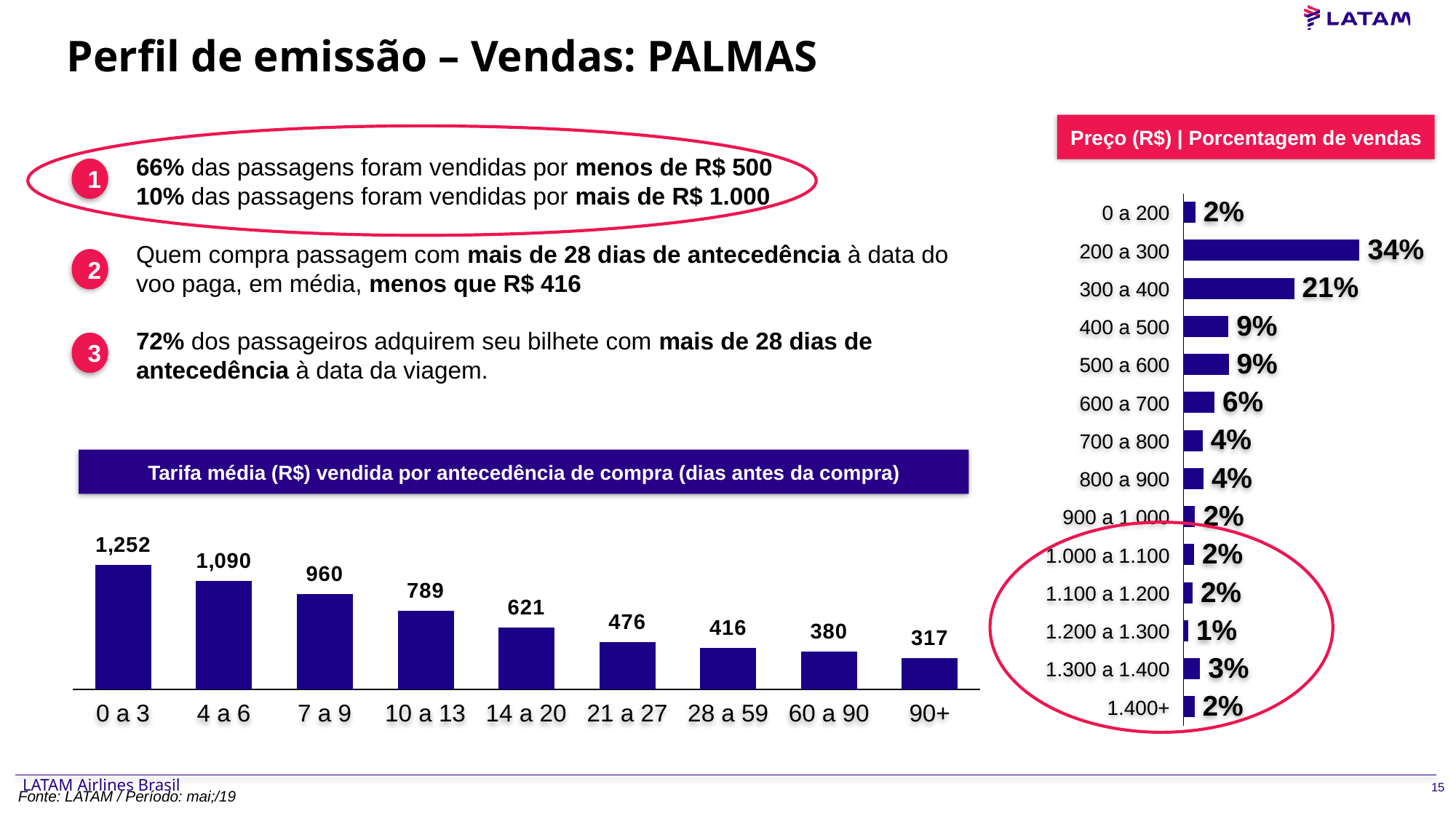
In the 'Tarifa média (R$) vendida por antecedência de compra' chart, do the values rise or fall from left to right along the x axis? fall What kind of chart is the 'Preço (R$) | Porcentagem de vendas' chart? bar chart In the 'Preço (R$) | Porcentagem de vendas' chart, what is the value for '300 a 400'? 21% In the 'Tarifa média (R$) vendida por antecedência de compra' chart, what is the value for '0 a 3'? 1,252 In the 'Preço (R$) | Porcentagem de vendas' chart, which price range has the highest percentage of sales? 200 a 300 In the 'Tarifa média (R$) vendida por antecedência de compra' chart, what is the value for '28 a 59'? 416 In the 'Tarifa média (R$) vendida por antecedência de compra' chart, which category has the lowest value? 90+ In the 'Tarifa média (R$) vendida por antecedência de compra' chart, what is the difference between the values for '4 a 6' and '7 a 9'? 130 In the 'Preço (R$) | Porcentagem de vendas' chart, which is larger: the value for '600 a 700' or the value for '1.300 a 1.400'? 600 a 700 How many price ranges are shown in the 'Preço (R$) | Porcentagem de vendas' chart? 14 How many categories are shown in the 'Tarifa média (R$) vendida por antecedência de compra' chart? 9 In the 'Preço (R$) | Porcentagem de vendas' chart, which price range has the lowest percentage of sales? 1.200 a 1.300